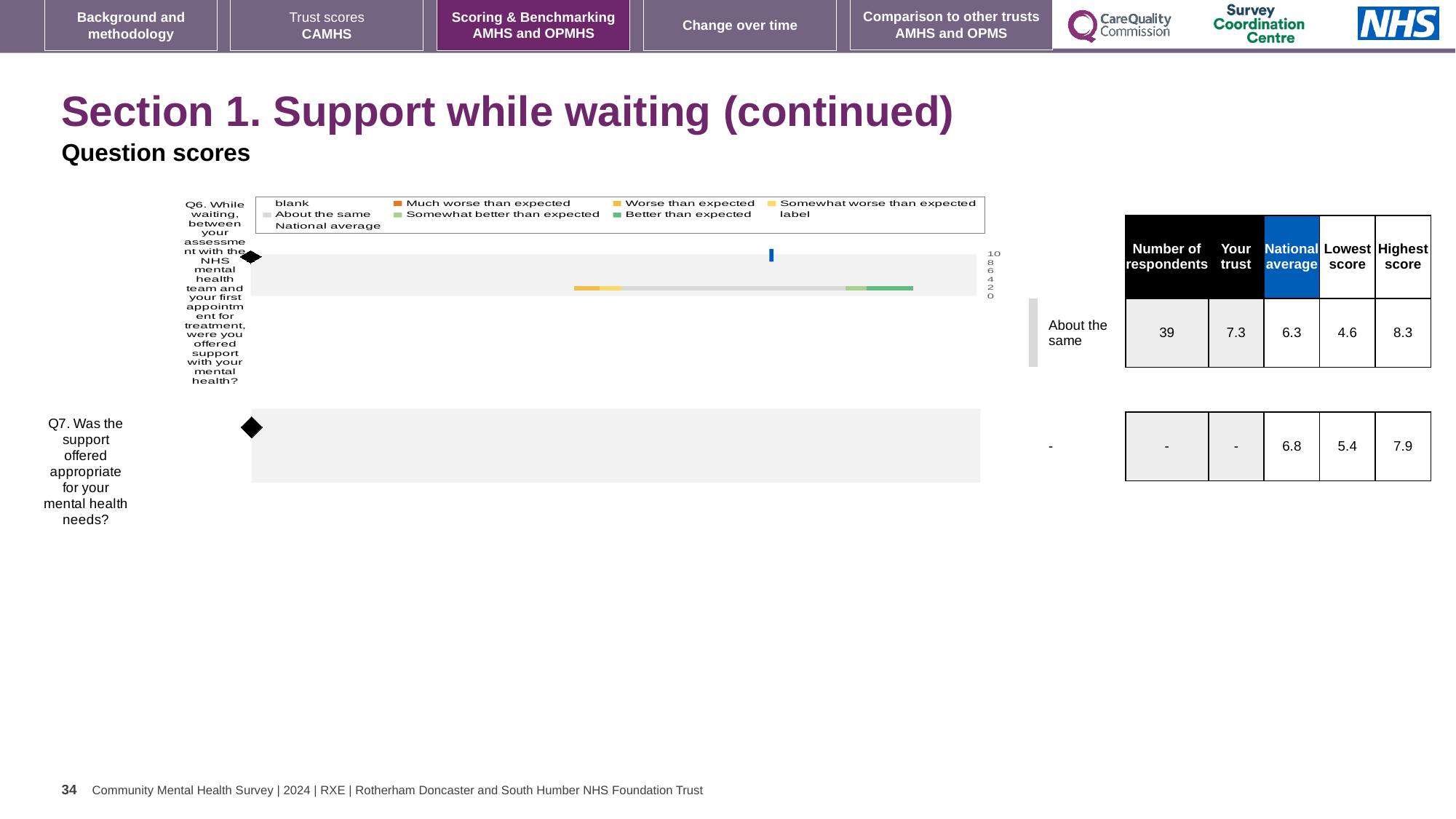
What is the national average score for Q6? 6.3 For Q6, which is larger: the 'Your trust' score or the national average? Your trust What kind of chart is shown on the slide? bar chart What colour does the legend use for 'Better than expected'? green What benchmark category is shown for Q6? About the same How many survey questions are plotted in the chart? 2 What is the national average score for Q7? 6.8 What is the difference between the highest score and the lowest score for Q6? 3.7 What is the 'Your trust' score for Q6? 7.3 What colour does the legend use for 'Much worse than expected'? orange How many entries does the chart legend list? 9 What is the number of respondents for Q6? 39